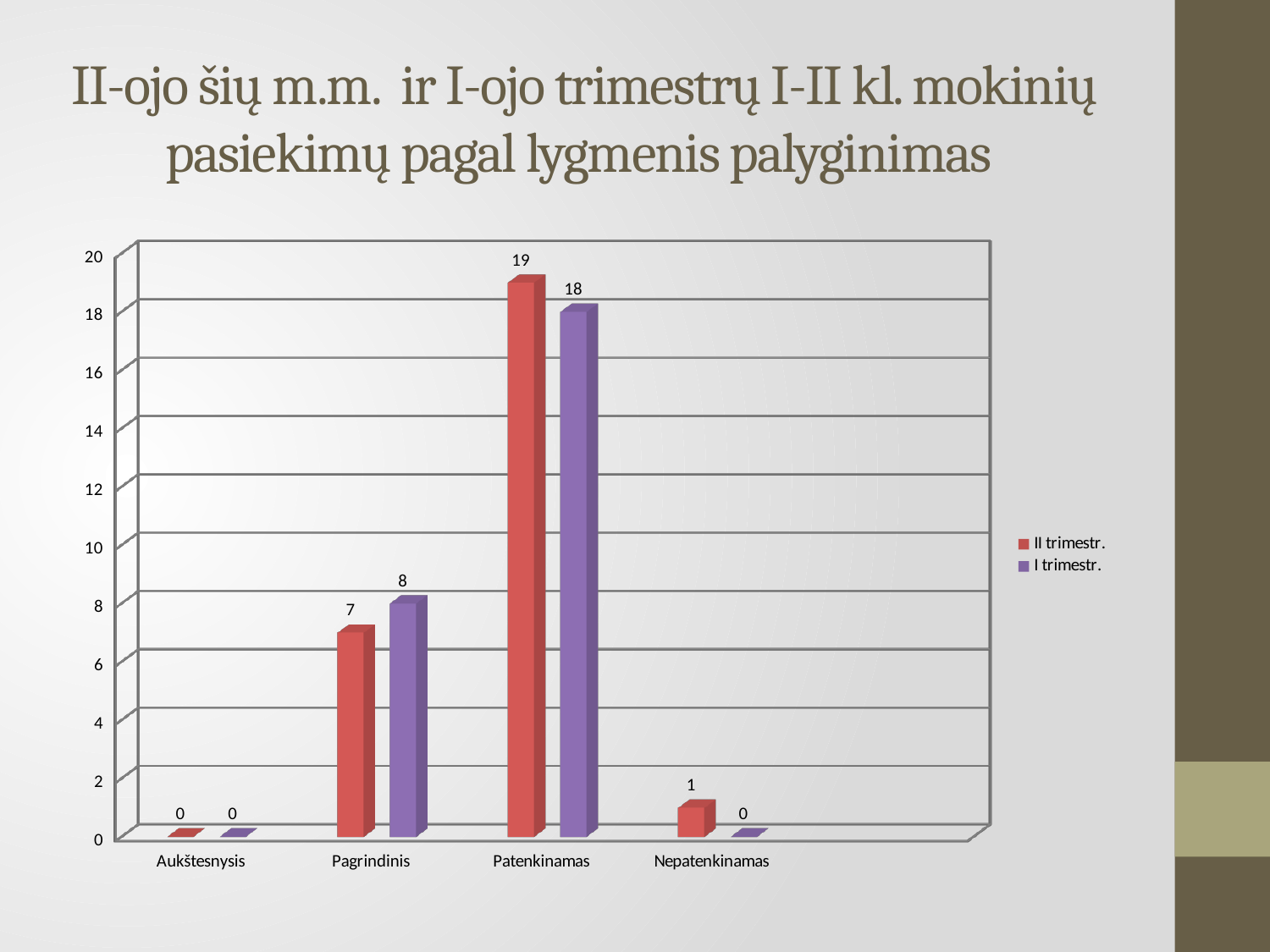
What kind of chart is shown on the slide? Bar chart What is the value for Patenkinamas in the II trimestr. series? 19 Which category has the highest value in the I trimestr. series? Patenkinamas How many categories are shown on the x axis? 4 What is the difference between the I trimestr. and II trimestr. values for Pagrindinis? 1 Which is larger for Pagrindinis: the II trimestr. value or the I trimestr. value? I trimestr. Which series is shown in purple according to the legend? I trimestr. What is the difference between the II trimestr. and I trimestr. values for Patenkinamas? 1 What is the value for Nepatenkinamas in the II trimestr. series? 1 What is the value for Pagrindinis in the I trimestr. series? 8 What is the value for Aukštesnysis in the I trimestr. series? 0 How many series does the legend list? 2